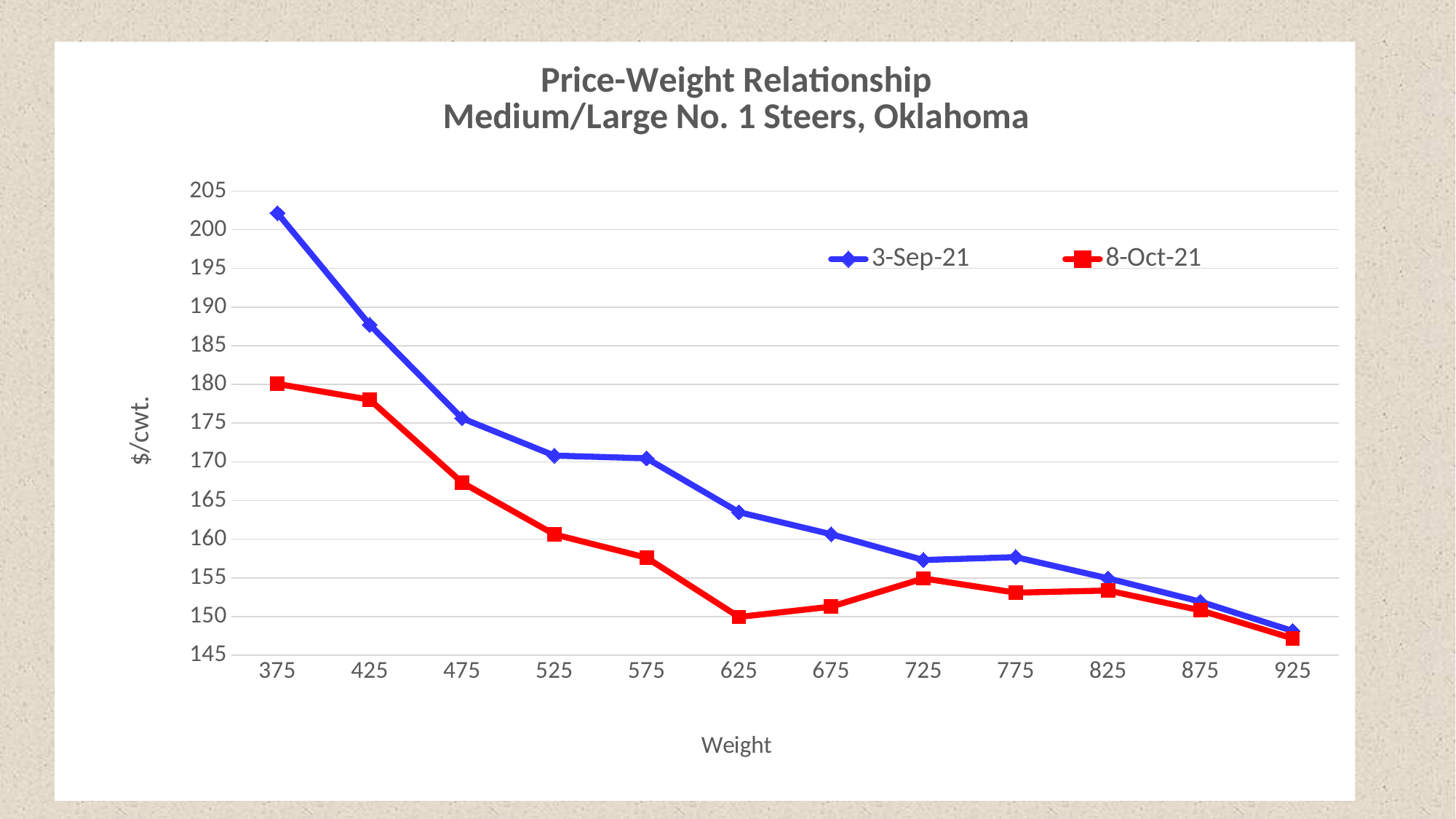
How many series does the legend list? 2 What kind of chart is shown on the slide? line chart At which weight is the 3-Sep-21 price highest? 375 What is the label on the horizontal axis? Weight What is the label on the vertical axis? $/cwt. Is the 8-Oct-21 value at a weight of 625 greater or less than 155? less At a weight of 475, which series has the higher price, 3-Sep-21 or 8-Oct-21? 3-Sep-21 Is the 3-Sep-21 value at a weight of 375 greater or less than 200? greater Is the 3-Sep-21 value at a weight of 425 greater or less than 185? greater At which weight is the 8-Oct-21 price lowest? 925 Do the 3-Sep-21 prices generally rise or fall as weight increases? fall How many weight categories are shown on the x axis? 12